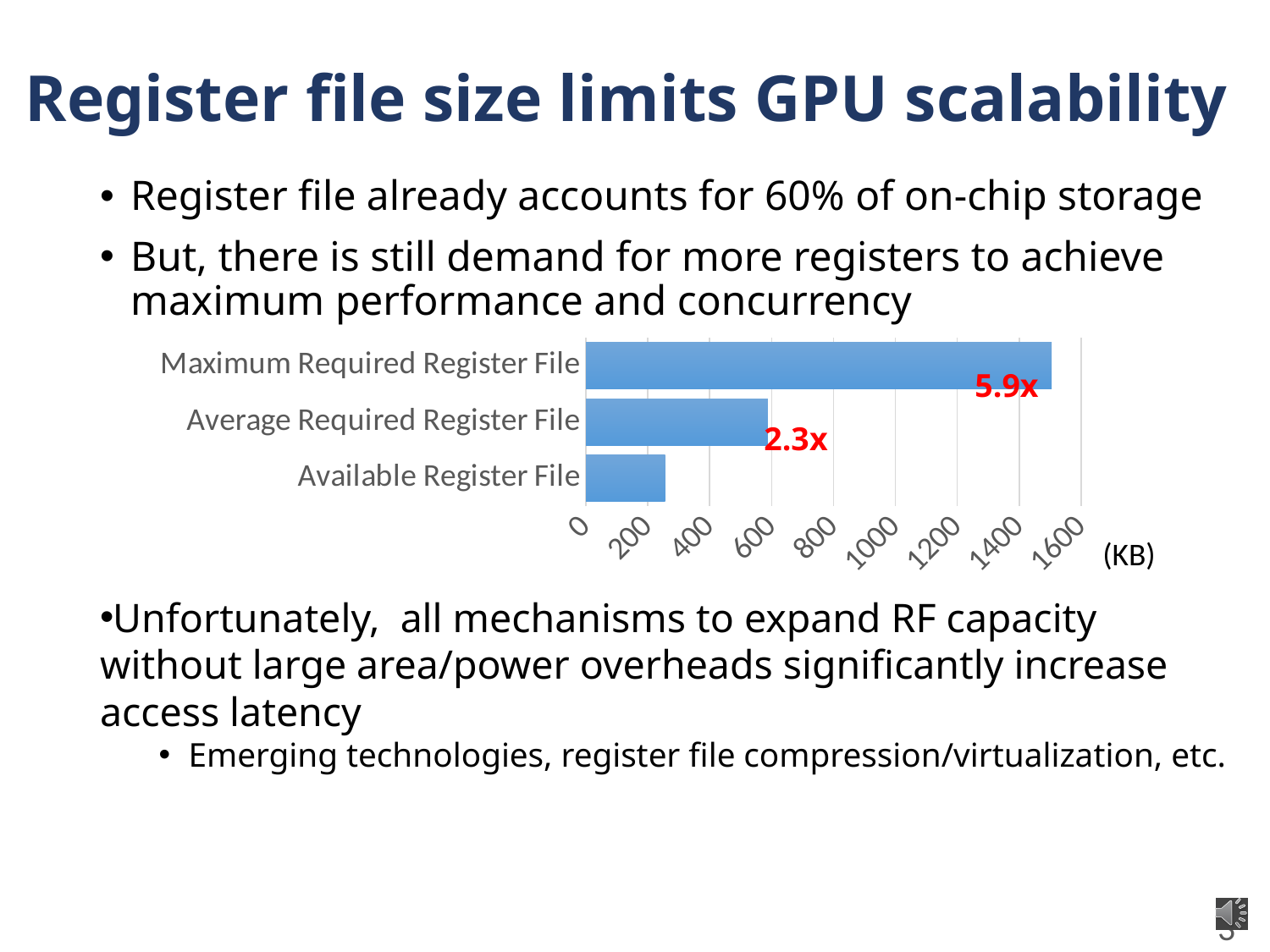
Is the value for Maximum Required Register File greater or less than 1400? greater What red annotation is printed next to the Maximum Required Register File bar? 5.9x Is the value for Average Required Register File greater or less than 400? greater Which is larger, the Average Required Register File or the Available Register File? Average Required Register File Is the value for Average Required Register File greater or less than 800? less Which category has the largest value in the chart? Maximum Required Register File Which category has the smallest value in the chart? Available Register File How many categories are plotted in the chart? 3 What kind of chart is shown on the slide? bar chart What unit is shown for the x axis of the chart? KB